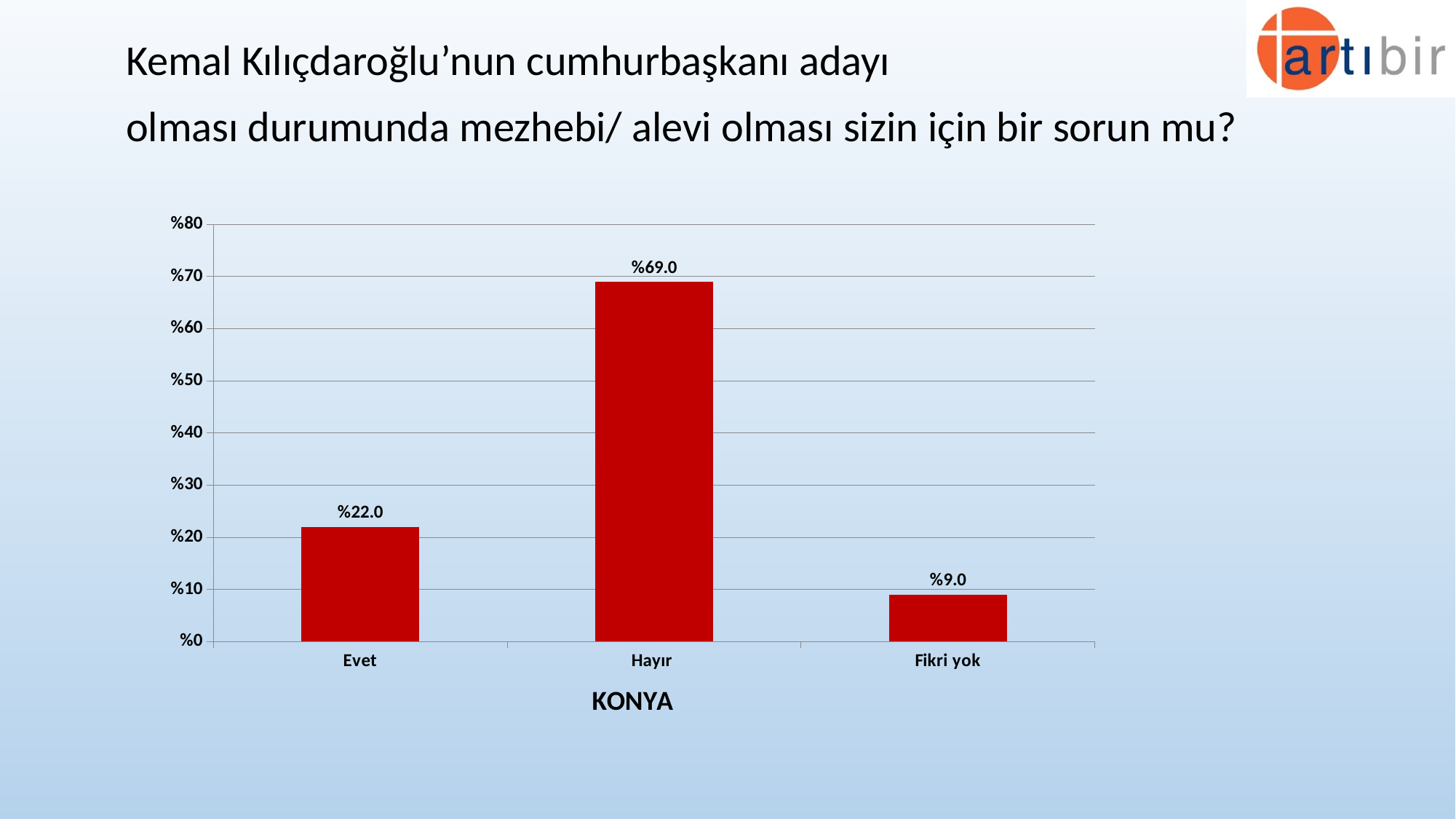
What is the value for Hayır? %69.0 What is the difference between the values for Hayır and Evet? %47.0 What is the difference between the values for Evet and Fikri yok? %13.0 What label appears below the x axis of the chart? KONYA What is the value for Fikri yok? %9.0 What is the value for Evet? %22.0 How many categories are shown on the x axis? 3 Which category has the lowest value? Fikri yok What kind of chart is shown on the slide? bar chart Which category has the highest value? Hayır Which is larger, the value for Evet or the value for Fikri yok? Evet Is the value for Hayır greater or less than %60? greater